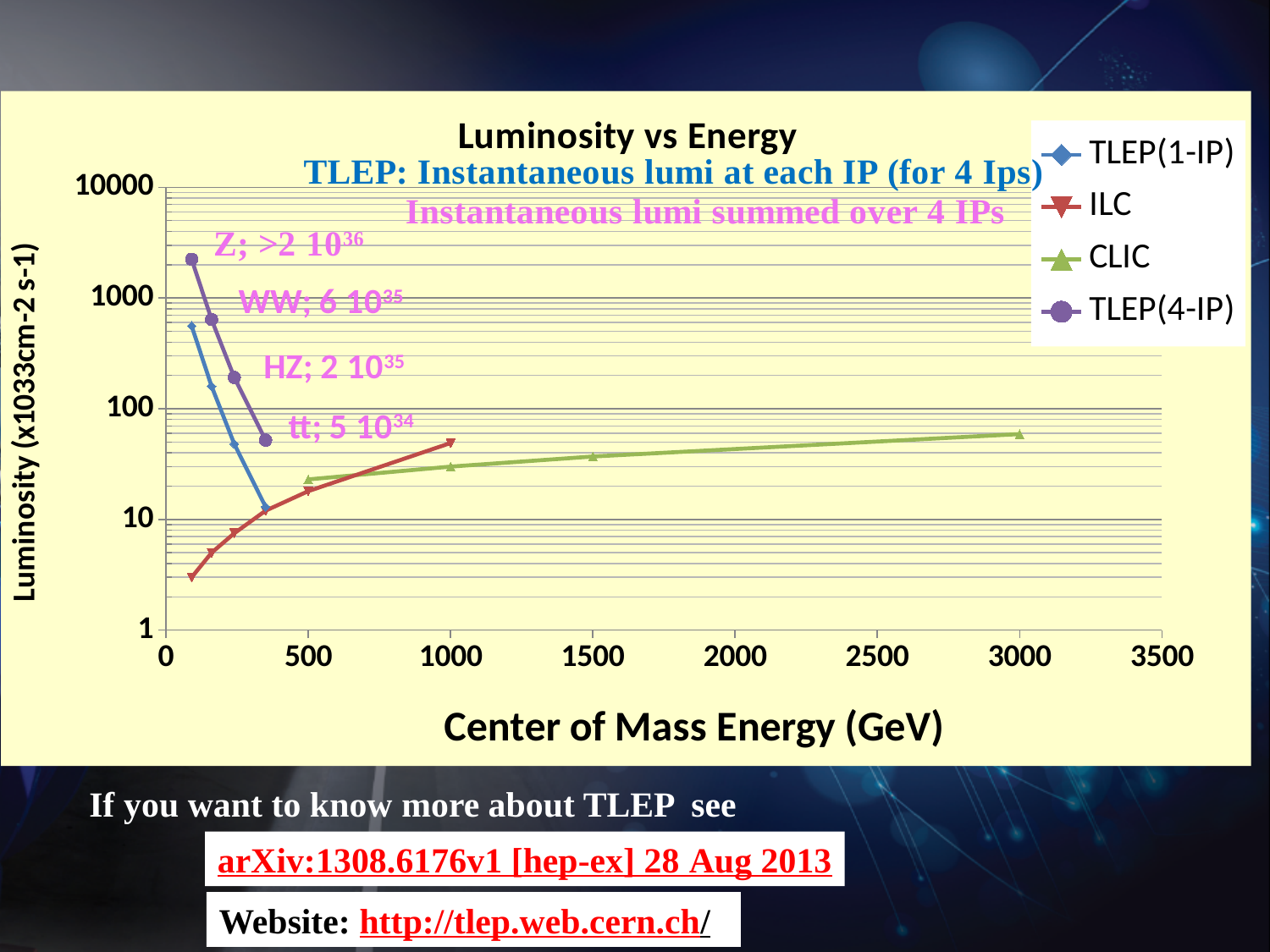
What is the label of the x axis of the chart? Center of Mass Energy (GeV) Is the luminosity of the CLIC series at 3000 GeV greater or less than 100? less Does the luminosity of the TLEP(4-IP) series rise or fall as the center of mass energy increases? fall Does the luminosity of the ILC series rise or fall as the center of mass energy increases? rise Is the luminosity of the ILC series at 1000 GeV greater or less than 10? greater Which series reaches the highest luminosity on the chart? TLEP(4-IP) What type of chart is shown on the slide? line chart Does the luminosity of the CLIC series rise or fall as the center of mass energy increases? rise How many series does the legend of the Luminosity vs Energy chart list? 4 At the lowest center of mass energy plotted, which series has the higher luminosity, TLEP(4-IP) or TLEP(1-IP)? TLEP(4-IP) What is the title of the chart? Luminosity vs Energy Is the highest luminosity of the TLEP(4-IP) series greater or less than 1000? greater